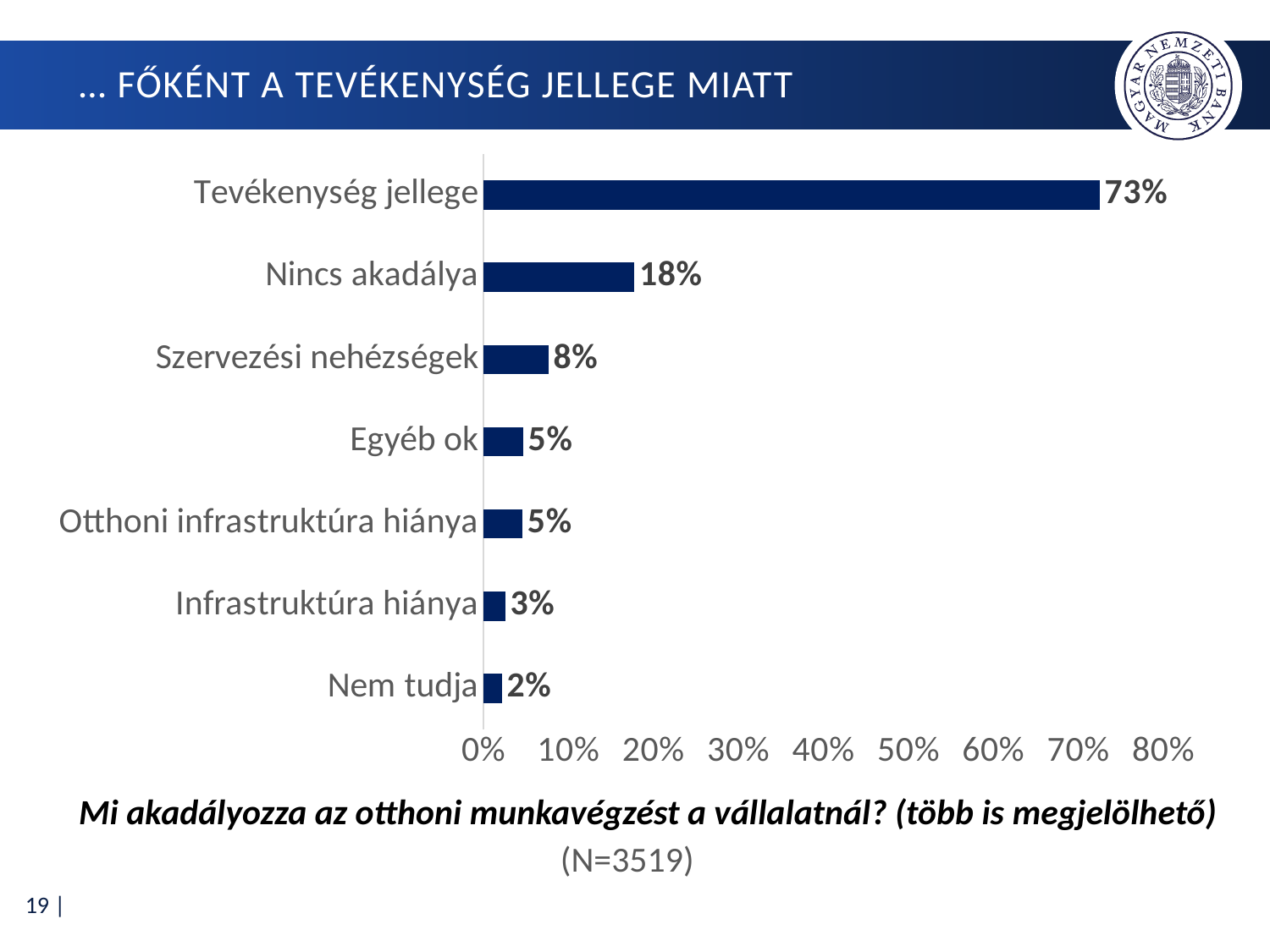
How many categories are shown in the chart? 7 What is the value for Tevékenység jellege? 73% Which category has the lowest value? Nem tudja What is the value for Nincs akadálya? 18% What is the value for Szervezési nehézségek? 8% Which is larger, the value for Szervezési nehézségek or the value for Egyéb ok? Szervezési nehézségek What is the value for Infrastruktúra hiánya? 3% Which category has the highest value? Tevékenység jellege What kind of chart is shown on the slide? bar chart What is the difference between the values for Tevékenység jellege and Nincs akadálya? 55% What is the sample size (N) stated below the chart? N=3519 Is the value for Tevékenység jellege greater or less than 70%? greater